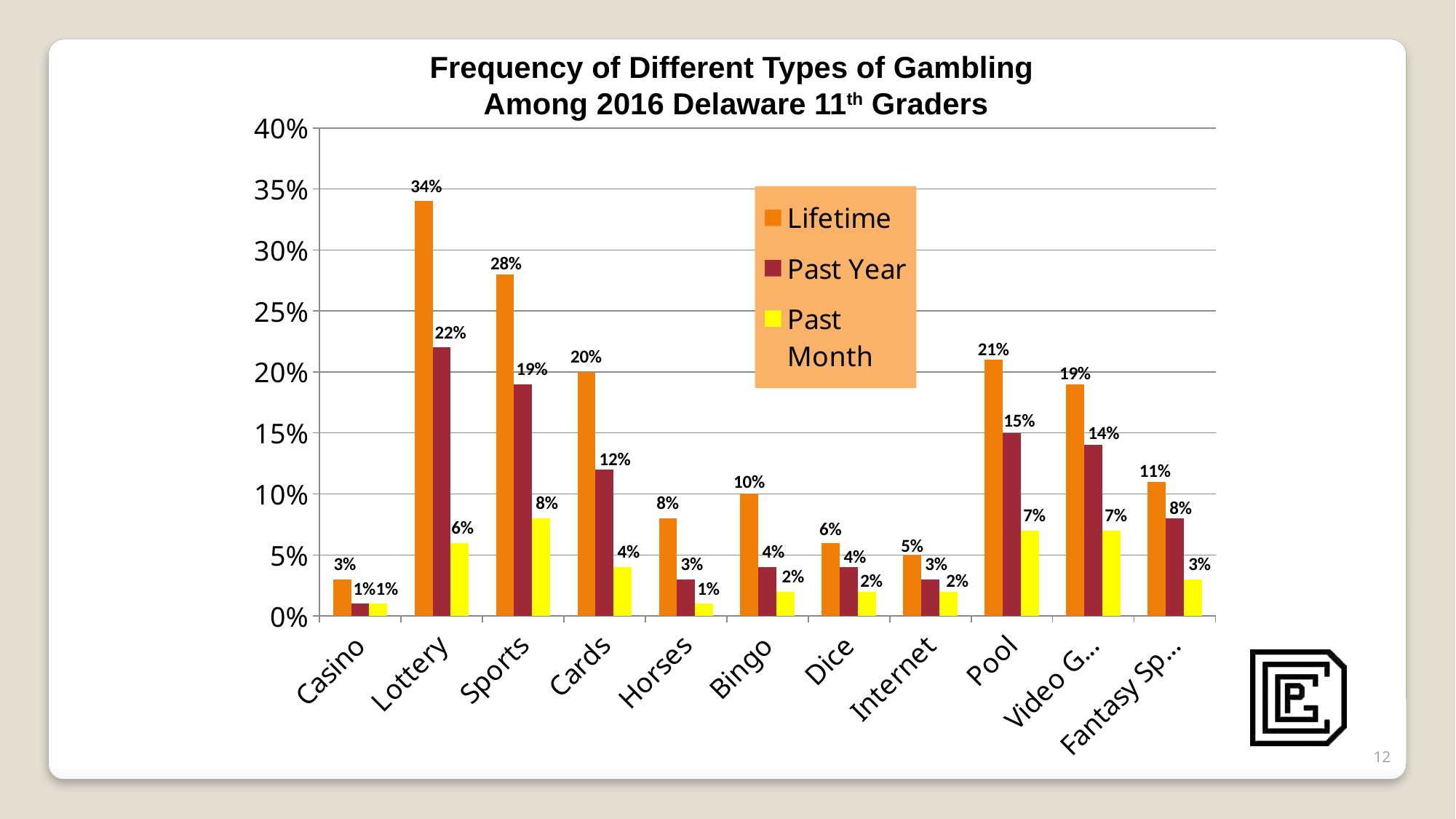
What is the Past Month value for Pool? 7% How many series does the legend list? 3 What kind of chart is shown on the slide? Bar chart Which series is shown in yellow in the legend? Past Month How many gambling categories are shown on the x axis? 11 What is the Lifetime value for Lottery? 34% Is the Lifetime value for Sports greater or less than 25%? greater Which is larger, the Lifetime value for Pool or the Lifetime value for Bingo? Pool What is the Past Year value for Sports? 19% Which category has the highest Lifetime value? Lottery What is the difference between the Lifetime and Past Year values for Cards? 8% Which category has the lowest Lifetime value? Casino